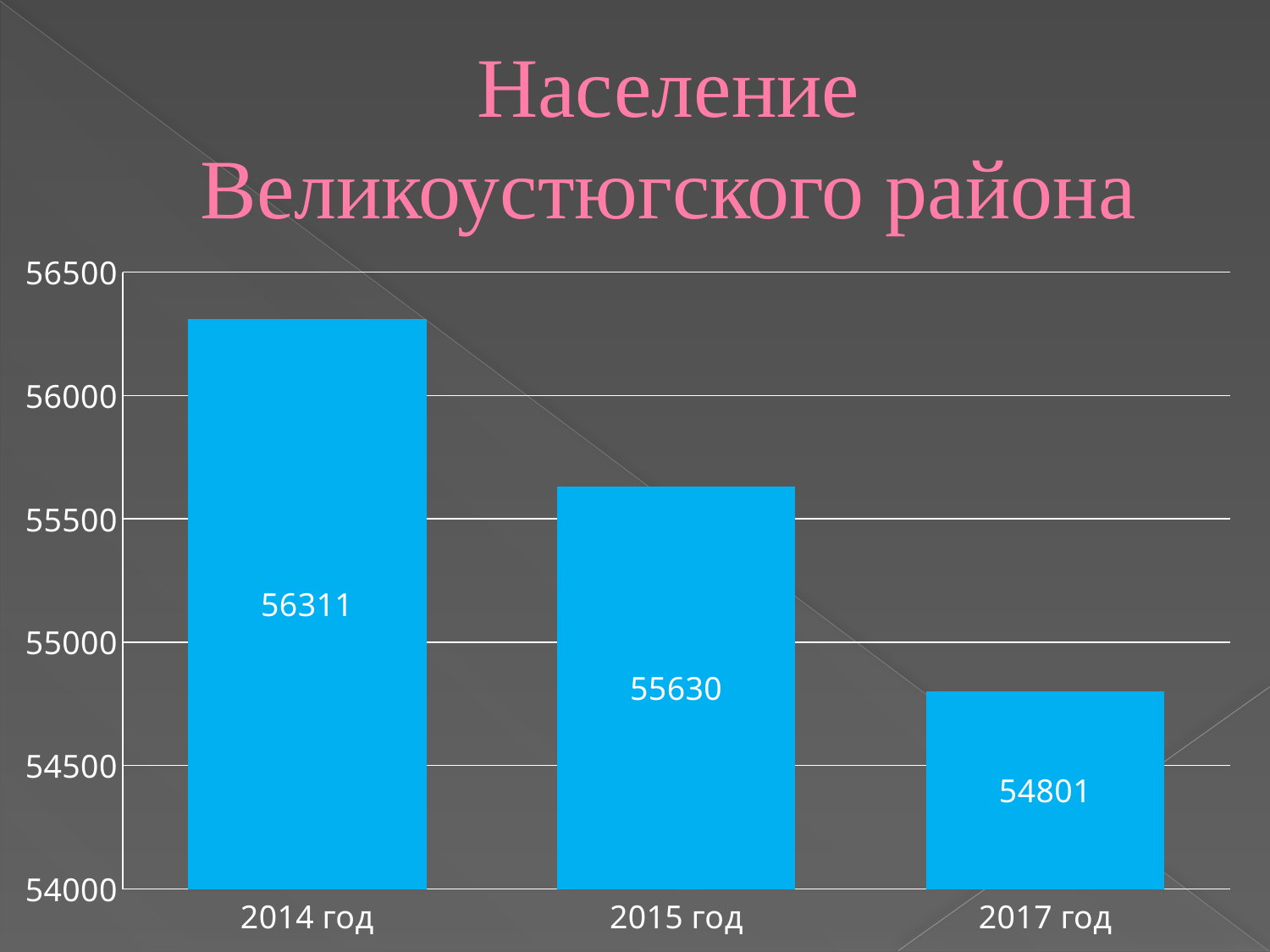
Which is larger, the value for 2015 год or the value for 2017 год? 2015 год Do the values rise or fall from 2014 год to 2017 год? fall Which year has the lowest population value? 2017 год What kind of chart is shown on the slide? bar chart What is the difference between the population values for 2014 год and 2017 год? 1510 What is the population value shown for 2017 год? 54801 What is the population value shown for 2014 год? 56311 Which year has the highest population value? 2014 год Is the value for 2015 год greater or less than 56000? less What is the population value shown for 2015 год? 55630 What is the difference between the population values for 2014 год and 2015 год? 681 How many years are shown on the chart? 3